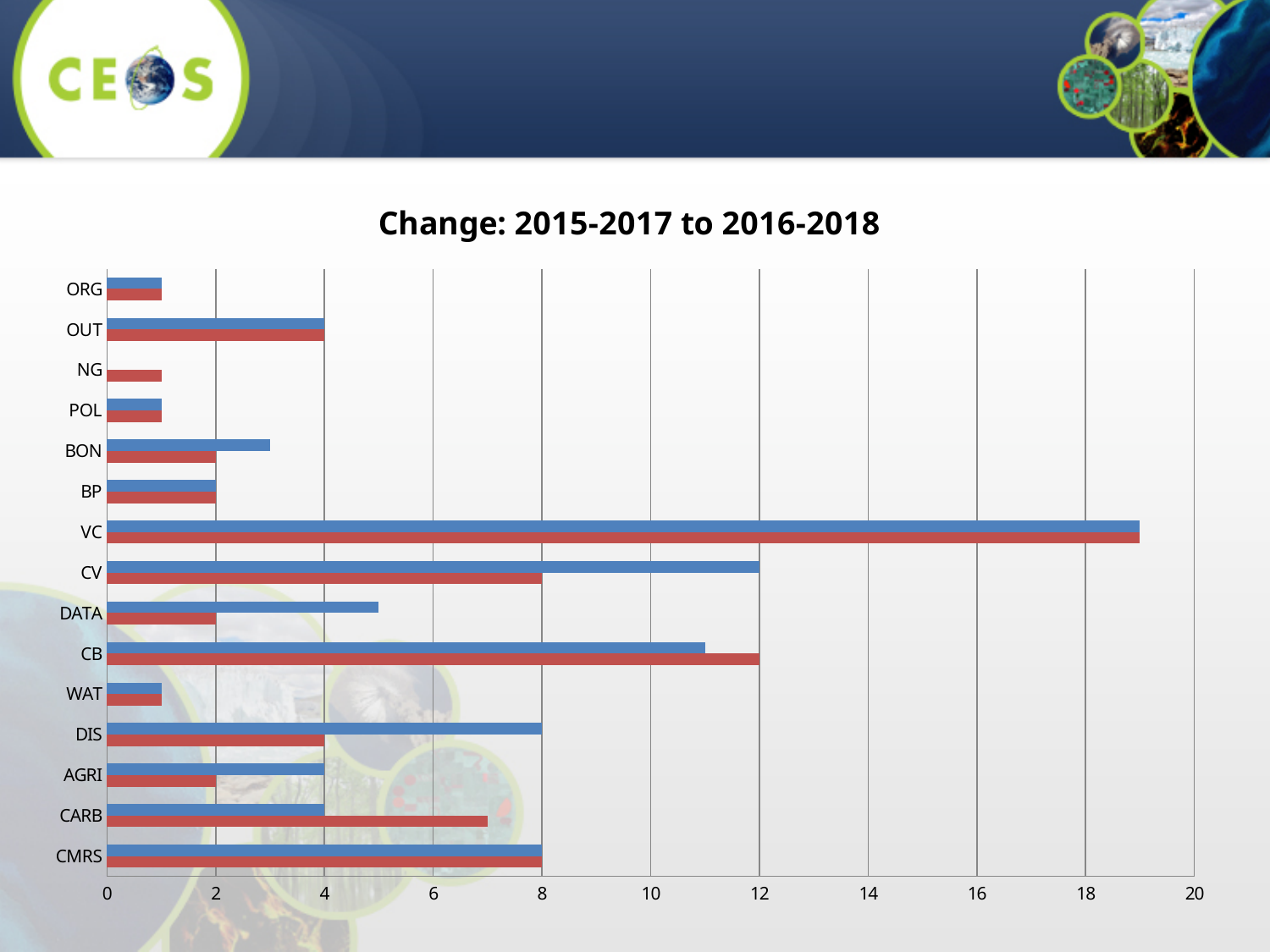
Is the value of the blue bar for VC greater or less than 18? greater What is the title of the chart? Change: 2015-2017 to 2016-2018 How many categories are listed on the vertical axis of the chart? 15 What is the value of the blue bar for DIS? 8 For CARB, which bar is longer, the blue bar or the red bar? red bar Which category has the longest red bar? VC Which category has the longest blue bar? VC What is the value of the red bar for CMRS? 8 What kind of chart is shown on the slide? bar chart What is the value of the blue bar for OUT? 4 Is the value of the red bar for CARB greater or less than 6? greater What is the difference between the blue bar and the red bar for DIS? 4